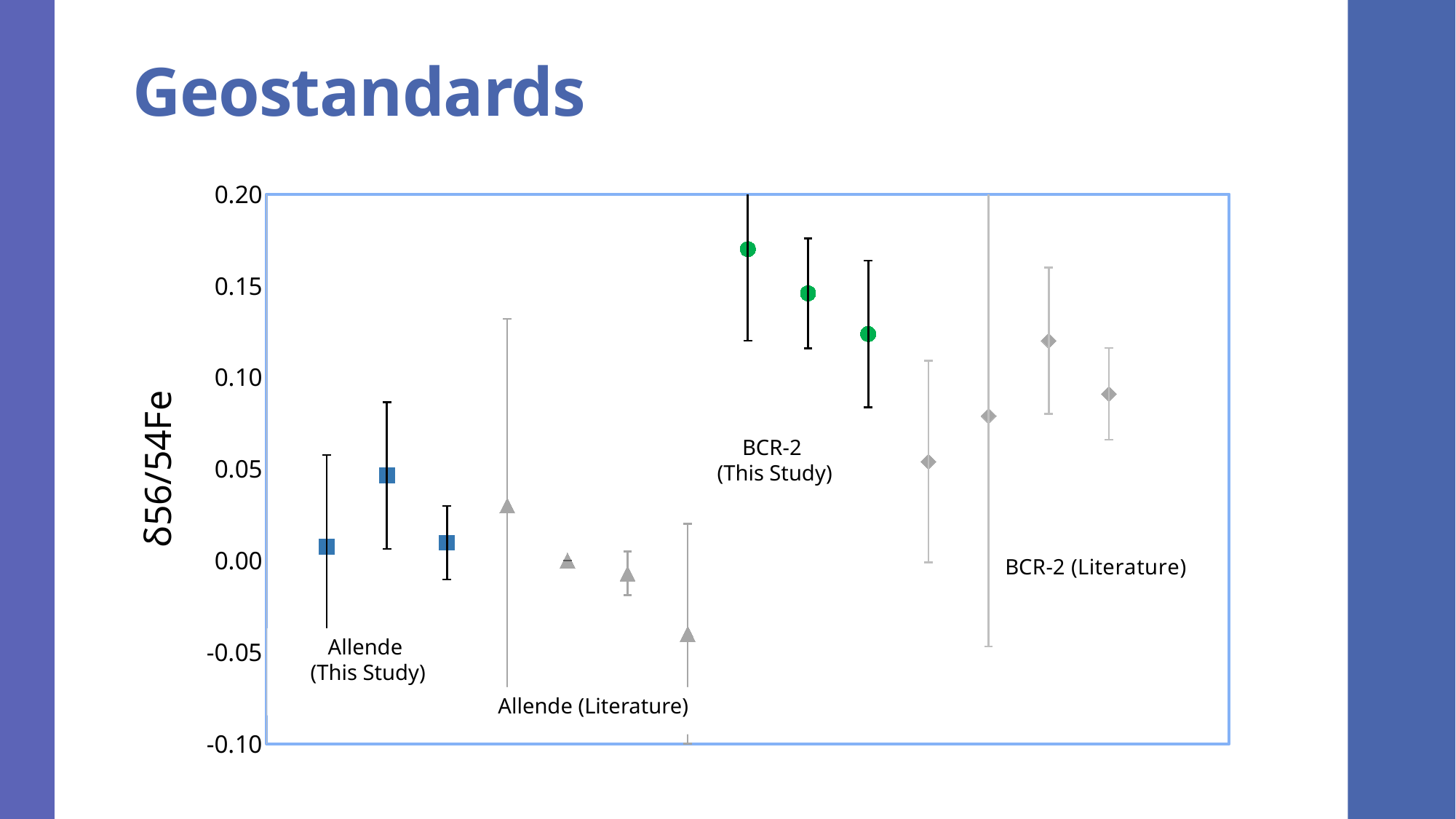
Which group has higher δ56/54Fe values, BCR-2 (This Study) or Allende (This Study)? BCR-2 (This Study) Is the lowest Allende (Literature) point greater or less than 0.00? less How many data points are plotted for BCR-2 (This Study)? 3 Is the highest BCR-2 (This Study) point greater or less than 0.15? greater Are the values for BCR-2 (This Study) greater or less than 0.10? greater What kind of chart is shown on the slide? Scatter chart with error bars What is the label on the y axis of the chart? δ56/54Fe Which labelled group contains the highest plotted δ56/54Fe value? BCR-2 (This Study) How many data points are plotted for Allende (Literature)? 4 How many sample groups are labelled on the chart? 4 What is the title of the slide containing the chart? Geostandards